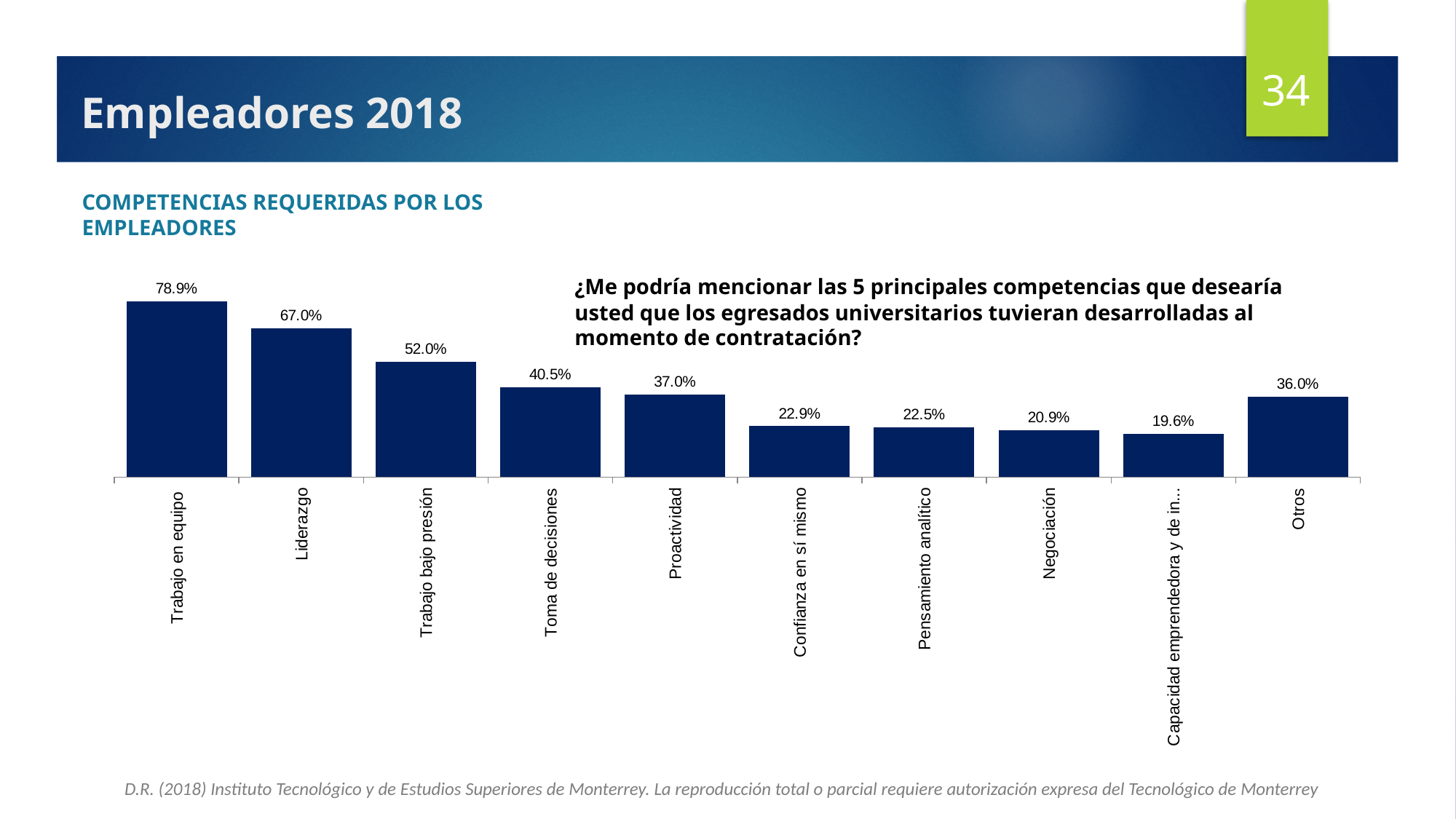
What is the value for Proactividad? 37.0% Which is larger, the value for Toma de decisiones or the value for Otros? Toma de decisiones What is the value for Otros? 36.0% What kind of chart is shown on the slide? Bar chart What is the value for Negociación? 20.9% What is the value for Liderazgo? 67.0% How many categories are shown in the chart? 10 What is the title of the chart? COMPETENCIAS REQUERIDAS POR LOS EMPLEADORES Which category has the lowest value? Capacidad emprendedora y de in... Which category has the highest value? Trabajo en equipo What is the difference between the values for Trabajo en equipo and Liderazgo? 11.9% What is the value for Trabajo en equipo? 78.9%